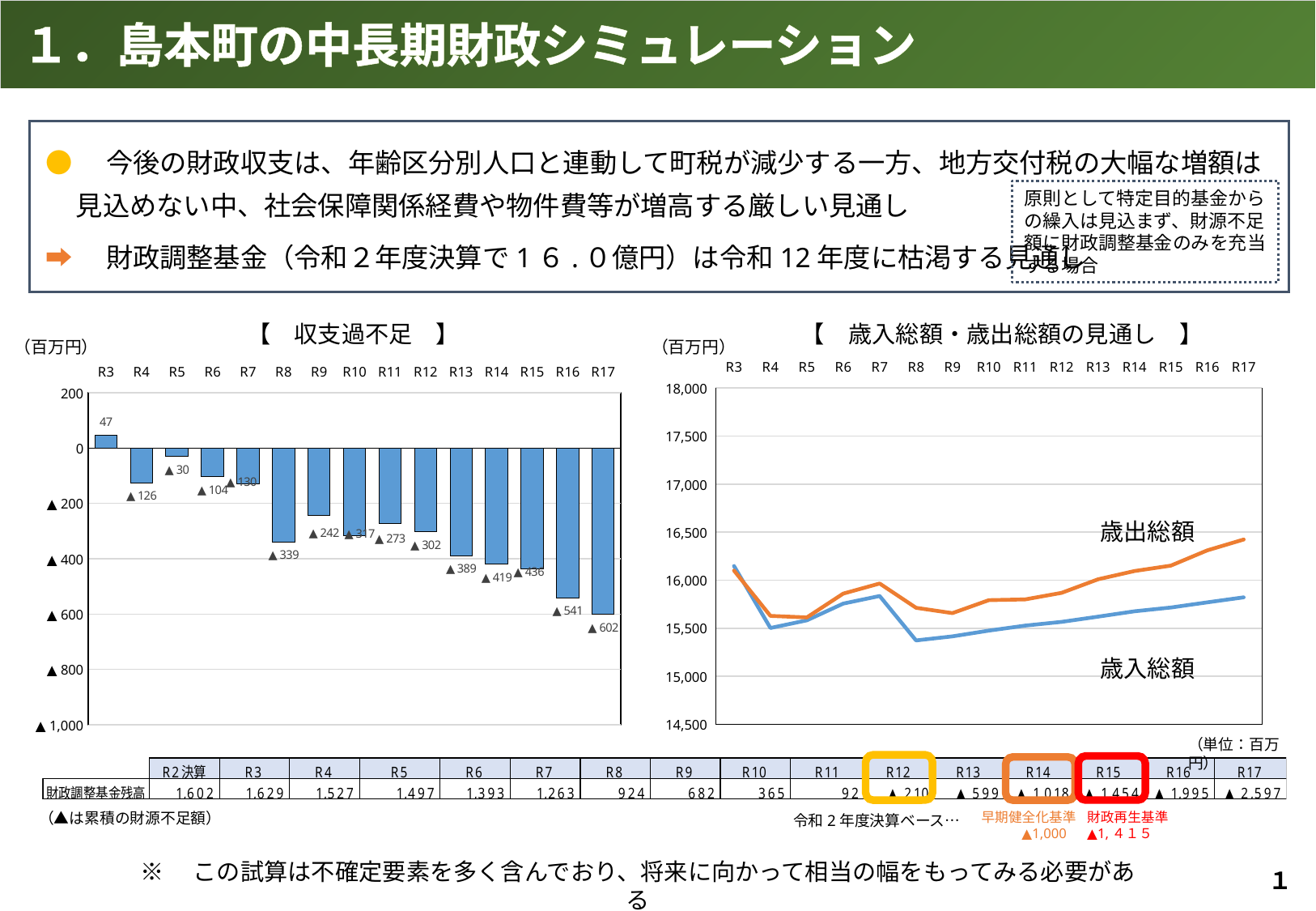
In the 収支過不足 chart, which year has the highest value? R3 How many years are plotted in the 収支過不足 chart? 15 How many series are plotted in the 歳入総額・歳出総額の見通し chart? 2 In the 収支過不足 chart, by how much does the deficit in R17 exceed the deficit in R16? 61 In the 歳入総額・歳出総額の見通し chart, is the 歳入総額 value for R8 greater or less than 15,500? less In the 収支過不足 chart, what is the value for R17? ▲602 What kind of chart is the 収支過不足 chart? Bar chart In the 収支過不足 chart, which year shows the larger deficit, R9 or R10? R10 In the 収支過不足 chart, which year has the lowest value? R17 In the 収支過不足 chart, what is the value for R3? 47 In the 収支過不足 chart, what is the value for R8? ▲339 In the 歳入総額・歳出総額の見通し chart, is the 歳出総額 value for R17 greater or less than 16,000? greater